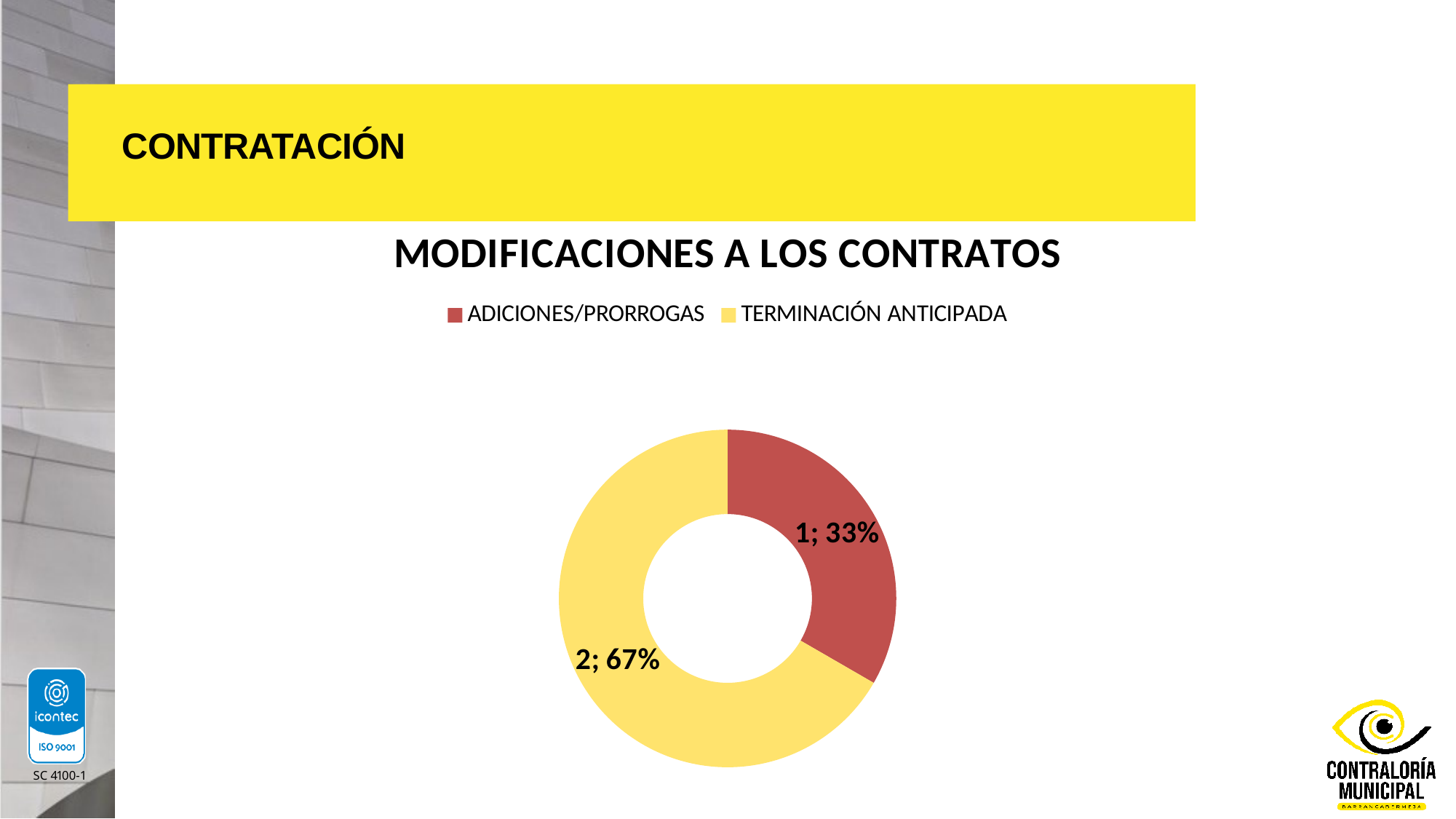
How many categories does the legend list? 2 What share of the chart does ADICIONES/PRORROGAS represent? 33% Which is larger, ADICIONES/PRORROGAS or TERMINACIÓN ANTICIPADA? TERMINACIÓN ANTICIPADA What type of chart is shown on the slide? Doughnut (pie) chart Which category has the smallest slice? ADICIONES/PRORROGAS Which category has the largest slice? TERMINACIÓN ANTICIPADA What is the difference between the values for TERMINACIÓN ANTICIPADA and ADICIONES/PRORROGAS? 1 What share of the chart does TERMINACIÓN ANTICIPADA represent? 67% What colour represents ADICIONES/PRORROGAS in the chart? Red What is the value for ADICIONES/PRORROGAS? 1 What is the value for TERMINACIÓN ANTICIPADA? 2 What is the title of the chart? MODIFICACIONES A LOS CONTRATOS